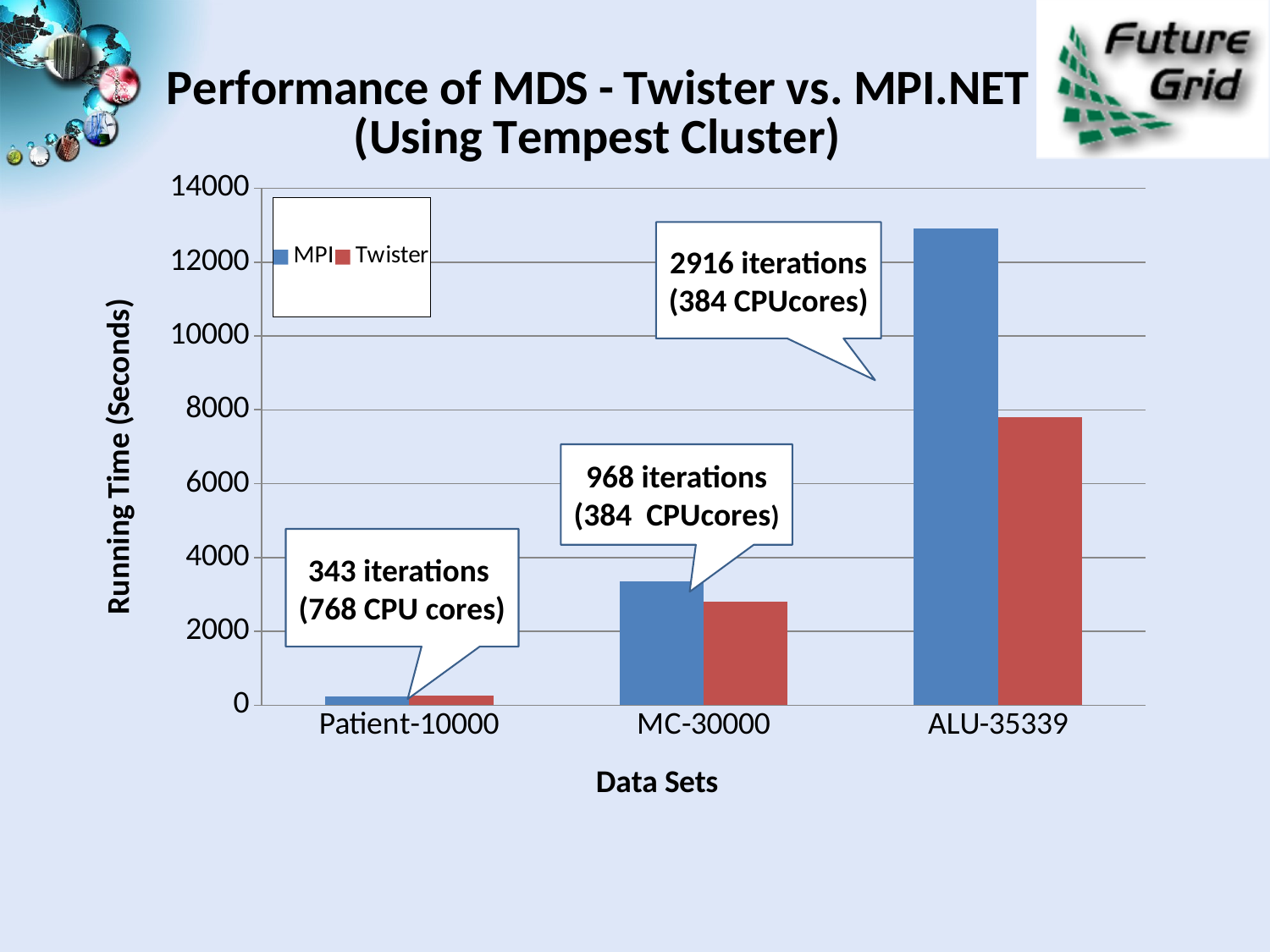
Is the MPI running time for MC-30000 greater or less than 4000? less Is the Twister running time for ALU-35339 greater or less than 8000? less Is the MPI running time for ALU-35339 greater or less than 12000? greater How many data sets are shown on the x axis? 3 How many series does the legend list? 2 For MC-30000, which is larger, the MPI running time or the Twister running time? MPI What is the label of the y axis? Running Time (Seconds) What kind of chart is shown on the slide? bar chart Which data set has the highest MPI running time? ALU-35339 Which data set has the lowest Twister running time? Patient-10000 For ALU-35339, which is larger, the MPI running time or the Twister running time? MPI Do the MPI running times rise or fall from Patient-10000 to ALU-35339? rise